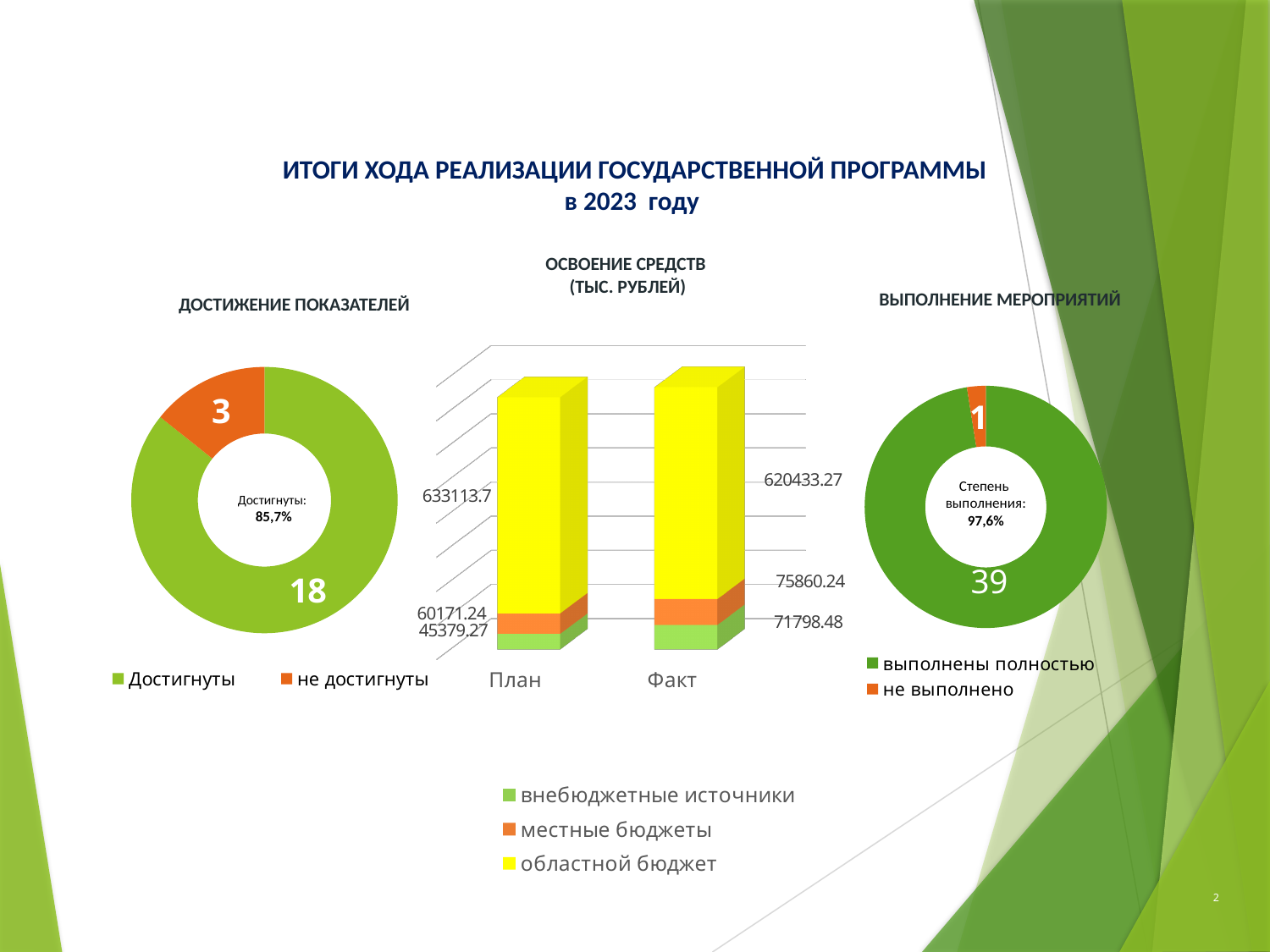
In the 'ОСВОЕНИЕ СРЕДСТВ (ТЫС. РУБЛЕЙ)' chart, what is the value of 'областной бюджет' for 'План'? 633113.7 In the 'ОСВОЕНИЕ СРЕДСТВ (ТЫС. РУБЛЕЙ)' chart, what is the value of 'областной бюджет' for 'Факт'? 620433.27 In the 'ДОСТИЖЕНИЕ ПОКАЗАТЕЛЕЙ' chart, what percentage is shown in the centre for 'Достигнуты'? 85,7% In the 'ОСВОЕНИЕ СРЕДСТВ (ТЫС. РУБЛЕЙ)' chart, how many series does the legend list? 3 In the 'ОСВОЕНИЕ СРЕДСТВ (ТЫС. РУБЛЕЙ)' chart, what is the difference between the 'областной бюджет' values for 'План' and 'Факт'? 12680.43 What type of chart is the 'ДОСТИЖЕНИЕ ПОКАЗАТЕЛЕЙ' chart? Doughnut chart In the 'ДОСТИЖЕНИЕ ПОКАЗАТЕЛЕЙ' chart, how many indicators are labelled 'Достигнуты'? 18 In the 'ВЫПОЛНЕНИЕ МЕРОПРИЯТИЙ' chart, which segment is smallest? не выполнено In the 'ВЫПОЛНЕНИЕ МЕРОПРИЯТИЙ' chart, how many activities are 'выполнены полностью'? 39 In the 'ВЫПОЛНЕНИЕ МЕРОПРИЯТИЙ' chart, what is the 'Степень выполнения' shown in the centre? 97,6% In the 'ОСВОЕНИЕ СРЕДСТВ (ТЫС. РУБЛЕЙ)' chart, which category has the larger 'областной бюджет' value, 'План' or 'Факт'? План In the 'ДОСТИЖЕНИЕ ПОКАЗАТЕЛЕЙ' chart, how many indicators are 'не достигнуты'? 3